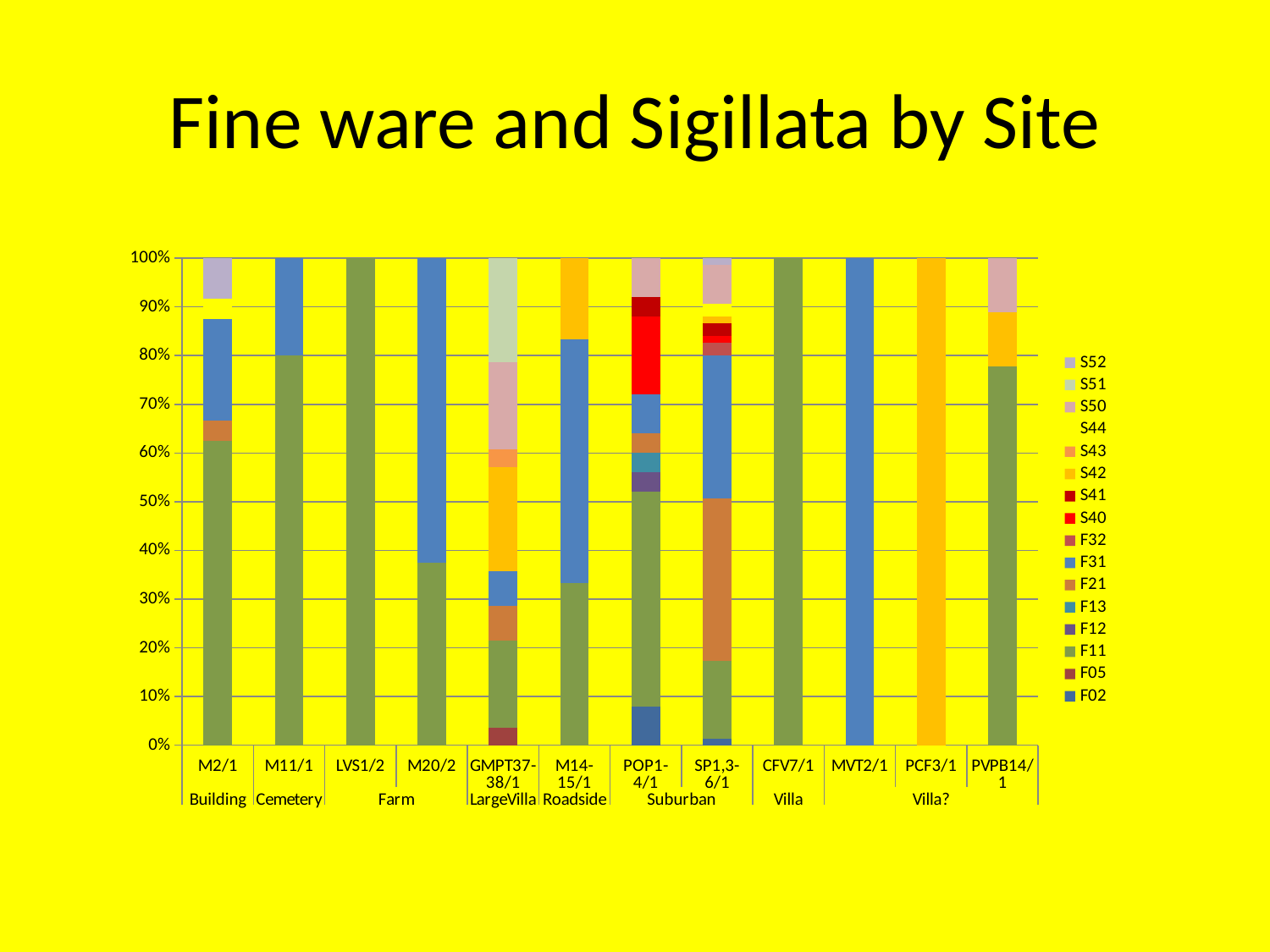
Is the F11 share for M11/1 greater or less than 70%? greater Is the F11 share for M20/2 greater or less than 50%? less Is the F11 share for M2/1 greater or less than 50%? greater How many series does the legend list? 16 What is the title of the chart? Fine ware and Sigillata by Site What kind of chart is shown on the slide? stacked bar chart What is the total of the stacked bar for LVS1/2? 100% How many site categories are shown along the x axis? 12 Which series makes up the entire bar for PCF3/1? S42